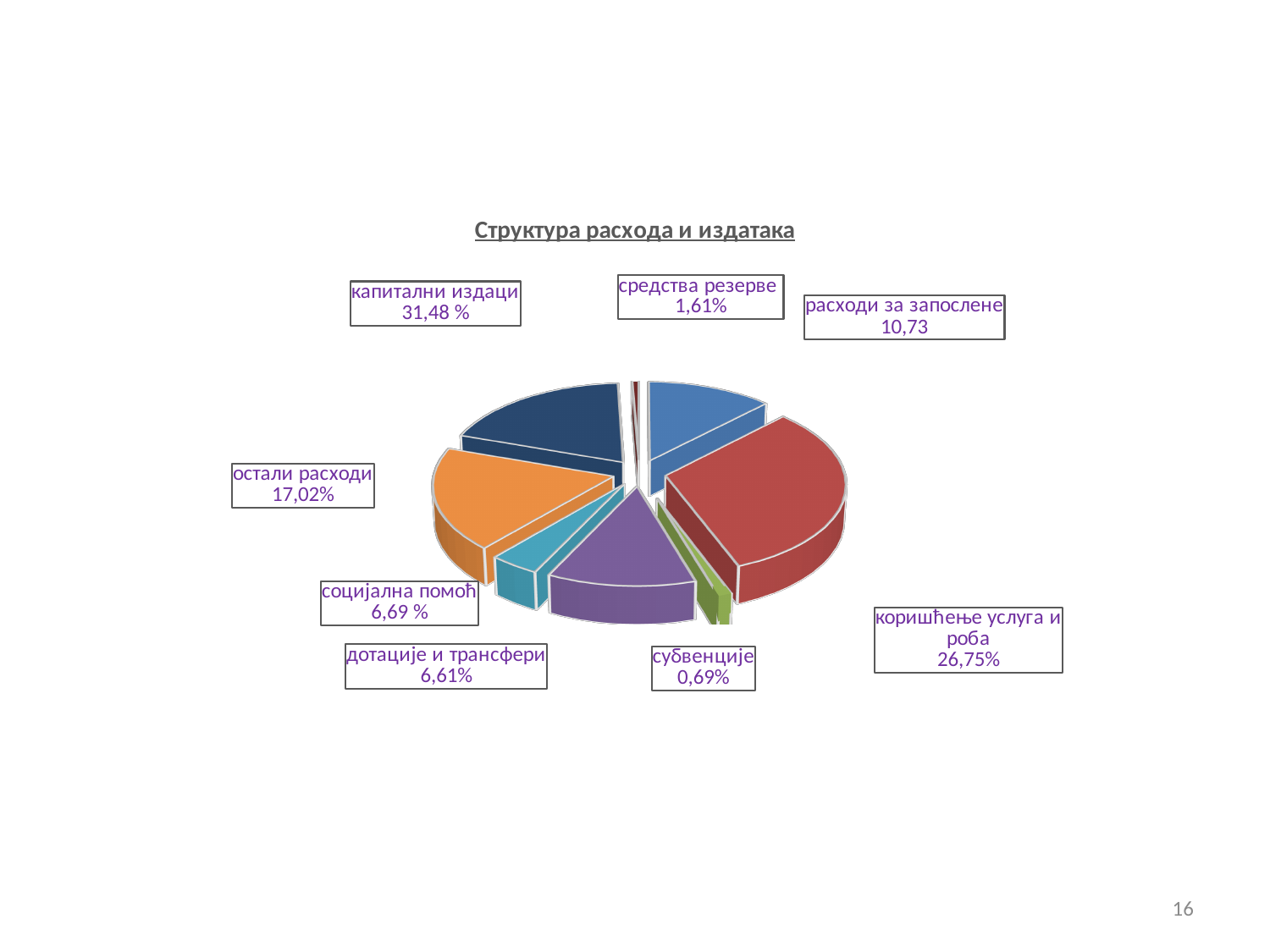
What is the difference between the values for капитални издаци and коришћење услуга и роба? 4,73 What is the title of the chart? Структура расхода и издатака What is the value shown for субвенције? 0,69% How many categories are labelled on the pie chart? 8 What is the value shown for капитални издаци? 31,48 % Which is larger, остали расходи or расходи за запослене? остали расходи What is the value shown for расходи за запослене? 10,73 What is the value shown for средства резерве? 1,61% What kind of chart is shown on the slide? pie chart What is the value shown for коришћење услуга и роба? 26,75%